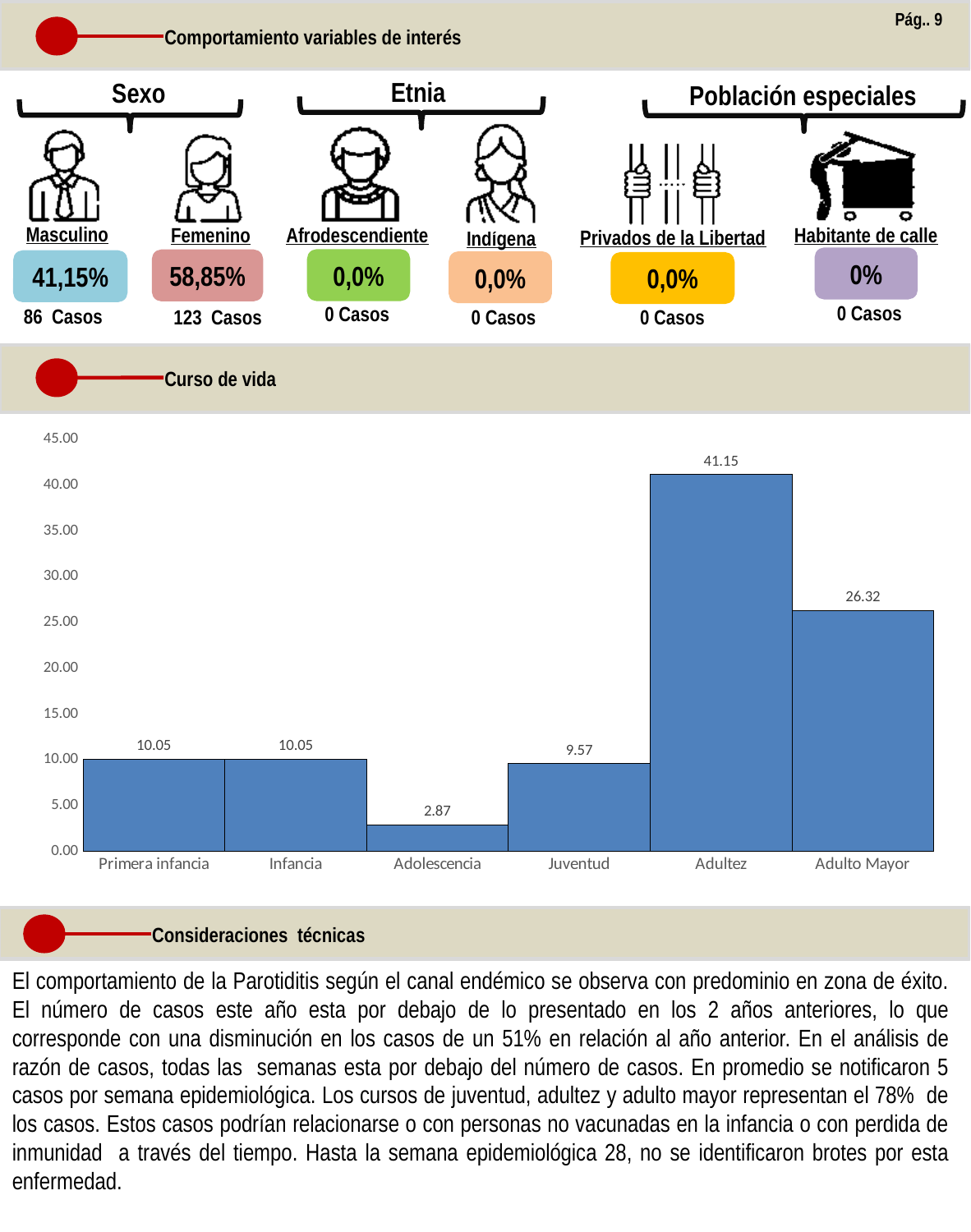
What is the value for Juventud in the Curso de vida chart? 9.57 Is the value for Adultez in the Curso de vida chart greater or less than 40.00? greater What is the value for Adultez in the Curso de vida chart? 41.15 What kind of chart is the Curso de vida chart? Bar chart What is the difference between the values for Adultez and Adolescencia in the Curso de vida chart? 38.28 What is the difference between the values for Adultez and Adulto Mayor in the Curso de vida chart? 14.83 What is the value for Adulto Mayor in the Curso de vida chart? 26.32 What is the value for Adolescencia in the Curso de vida chart? 2.87 How many categories are shown on the x axis of the Curso de vida chart? 6 In the Curso de vida chart, which is larger: the value for Adulto Mayor or the value for Infancia? Adulto Mayor Which category has the highest value in the Curso de vida chart? Adultez Which category has the lowest value in the Curso de vida chart? Adolescencia